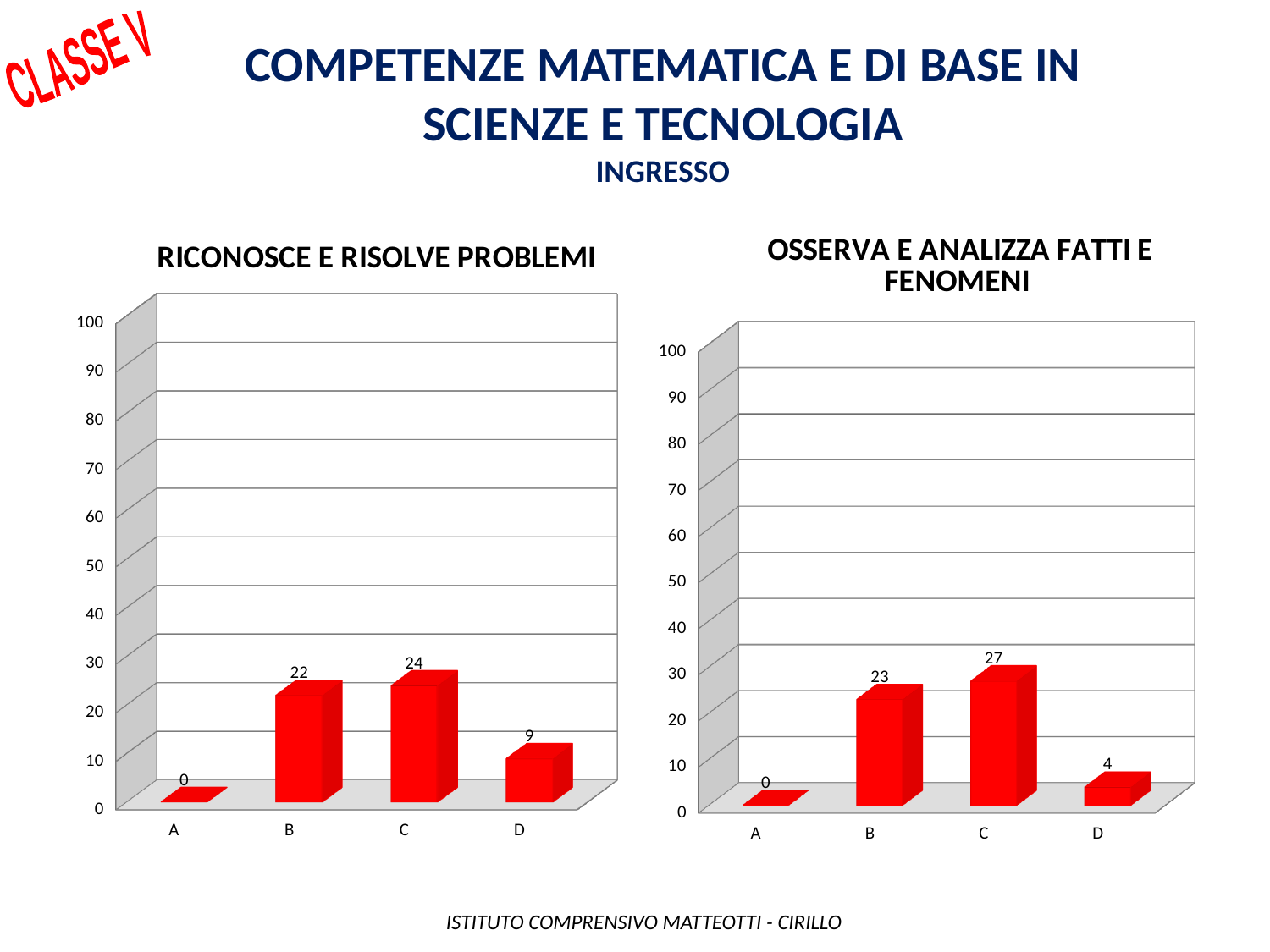
In the 'RICONOSCE E RISOLVE PROBLEMI' chart, which category has the highest value? C What kind of chart is the 'OSSERVA E ANALIZZA FATTI E FENOMENI' chart? Bar chart In the 'RICONOSCE E RISOLVE PROBLEMI' chart, what is the value for category B? 22 In the 'RICONOSCE E RISOLVE PROBLEMI' chart, what is the value for category D? 9 In the 'OSSERVA E ANALIZZA FATTI E FENOMENI' chart, what is the value for category C? 27 In the 'OSSERVA E ANALIZZA FATTI E FENOMENI' chart, which is larger, the value for B or the value for D? B In the 'OSSERVA E ANALIZZA FATTI E FENOMENI' chart, which category has the lowest value? A In the 'OSSERVA E ANALIZZA FATTI E FENOMENI' chart, what is the difference between the values for C and B? 4 In the 'OSSERVA E ANALIZZA FATTI E FENOMENI' chart, what is the value for category A? 0 What is the title of the chart on the left side of the slide? RICONOSCE E RISOLVE PROBLEMI In the 'RICONOSCE E RISOLVE PROBLEMI' chart, what is the difference between the values for C and D? 15 How many categories are shown in the 'RICONOSCE E RISOLVE PROBLEMI' chart? 4